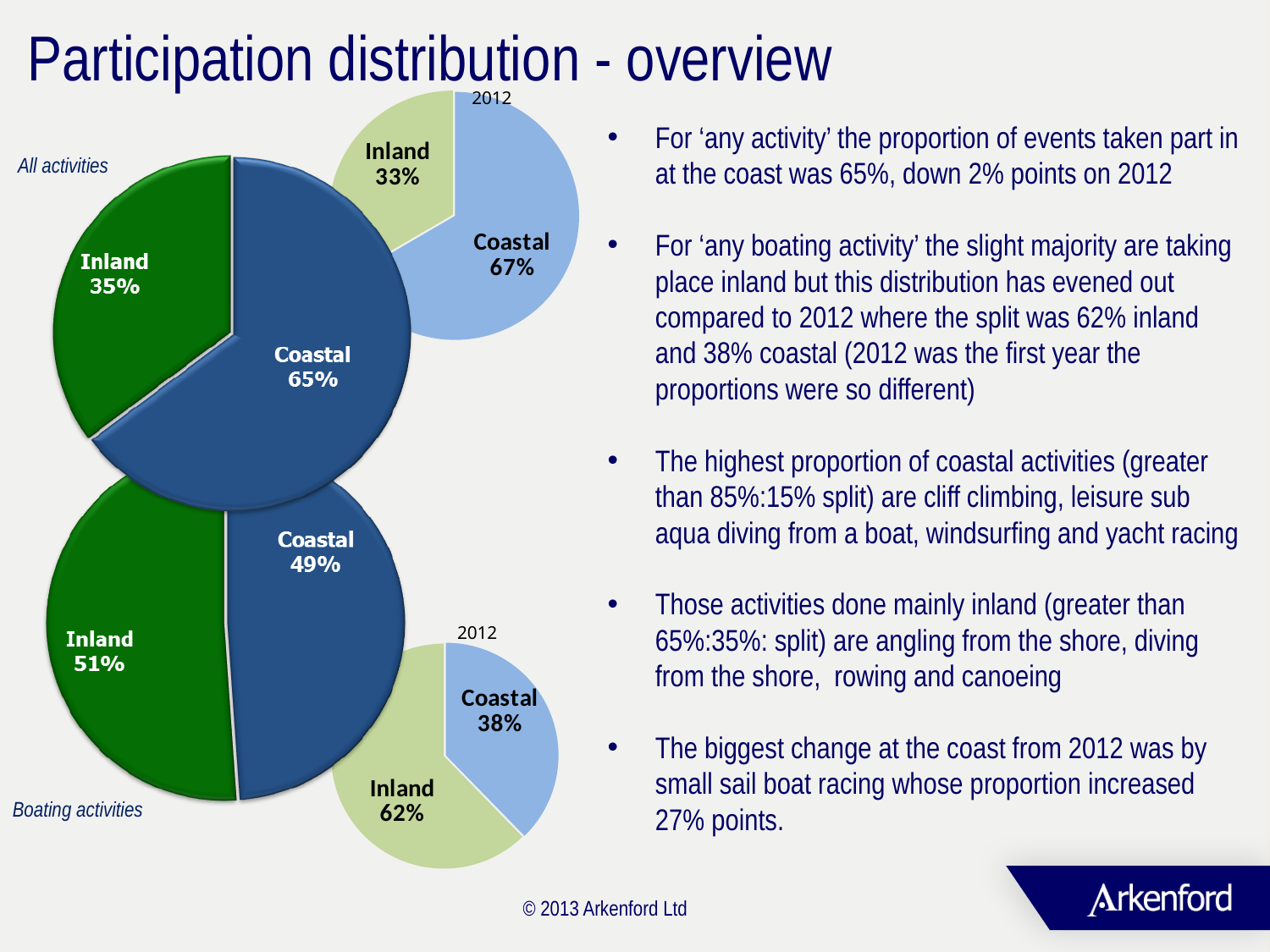
What kind of chart is the large 'Boating activities' chart? Pie chart In the large 'All activities' pie chart, which slice is the largest? Coastal In the small 2012 pie chart next to the 'All activities' chart, what share is Coastal? 67% In the large 'All activities' pie chart, what share is Coastal? 65% In the small 2012 pie chart next to the 'Boating activities' chart, what share is Inland? 62% In the large 'All activities' pie chart, what is the difference between the Coastal and Inland shares? 30% In the large 'Boating activities' pie chart, what share is Coastal? 49% In the small 2012 pie chart next to the 'Boating activities' chart, what share is Coastal? 38% In the large 'Boating activities' pie chart, what share is Inland? 51% In the small 2012 pie chart next to the 'Boating activities' chart, which slice is the smallest? Coastal In the small 2012 pie chart next to the 'All activities' chart, what share is Inland? 33% In the large 'All activities' pie chart, what share is Inland? 35%